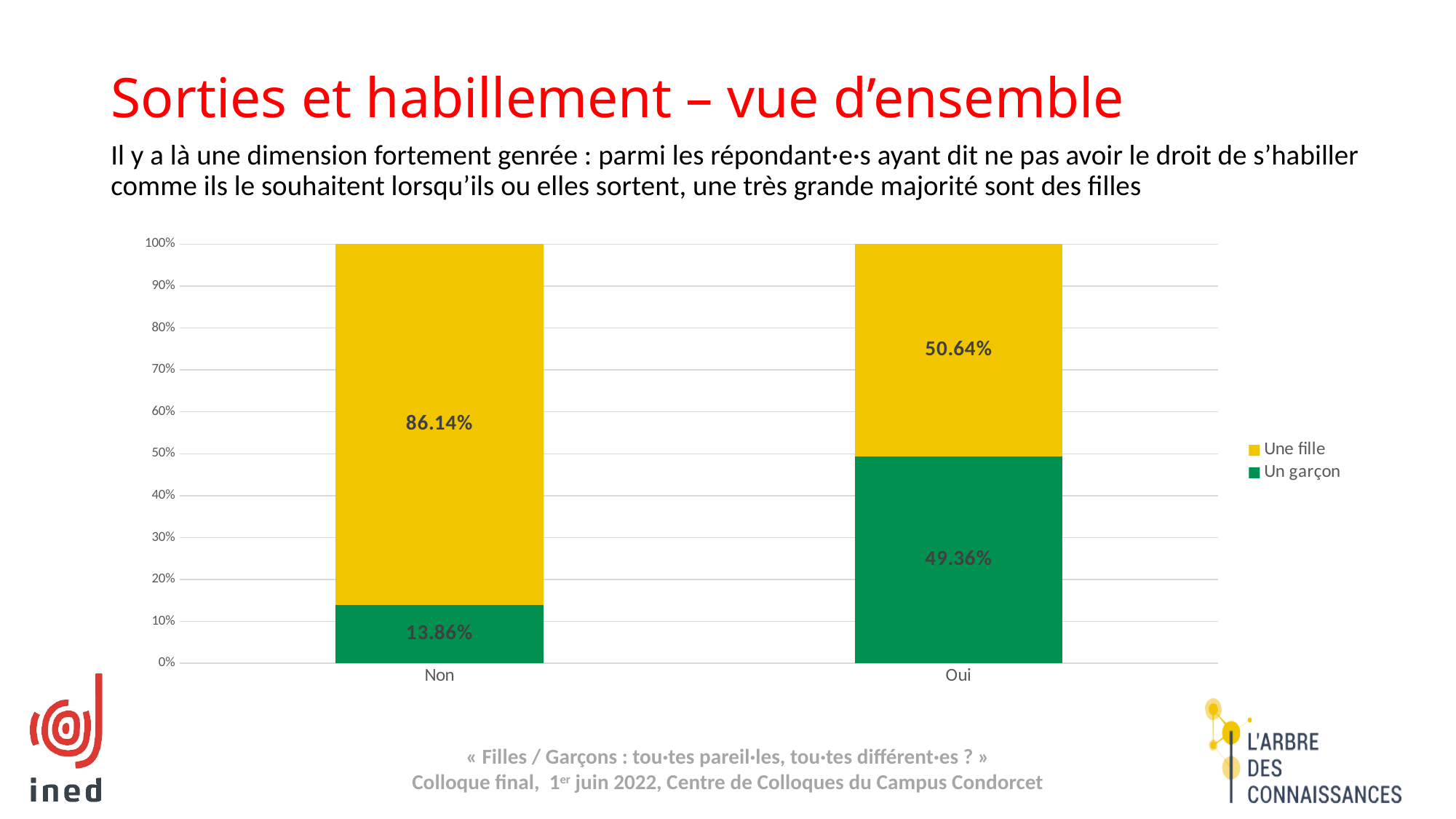
In which category is the share of "Une fille" lowest? Oui Is the value for "Un garçon" in the "Non" category greater or less than 20%? less How many categories are shown on the x axis? 2 How many series does the legend list? 2 In which category is the share of "Un garçon" highest? Oui What kind of chart is shown on the slide? Stacked bar chart What is the value for "Une fille" in the "Oui" category? 50.64% What is the difference between the "Une fille" share in "Non" and the "Une fille" share in "Oui"? 35.50% Within the "Non" category, which is larger: the share of "Une fille" or the share of "Un garçon"? Une fille What is the value for "Un garçon" in the "Non" category? 13.86% What is the value for "Un garçon" in the "Oui" category? 49.36% What is the value for "Une fille" in the "Non" category? 86.14%